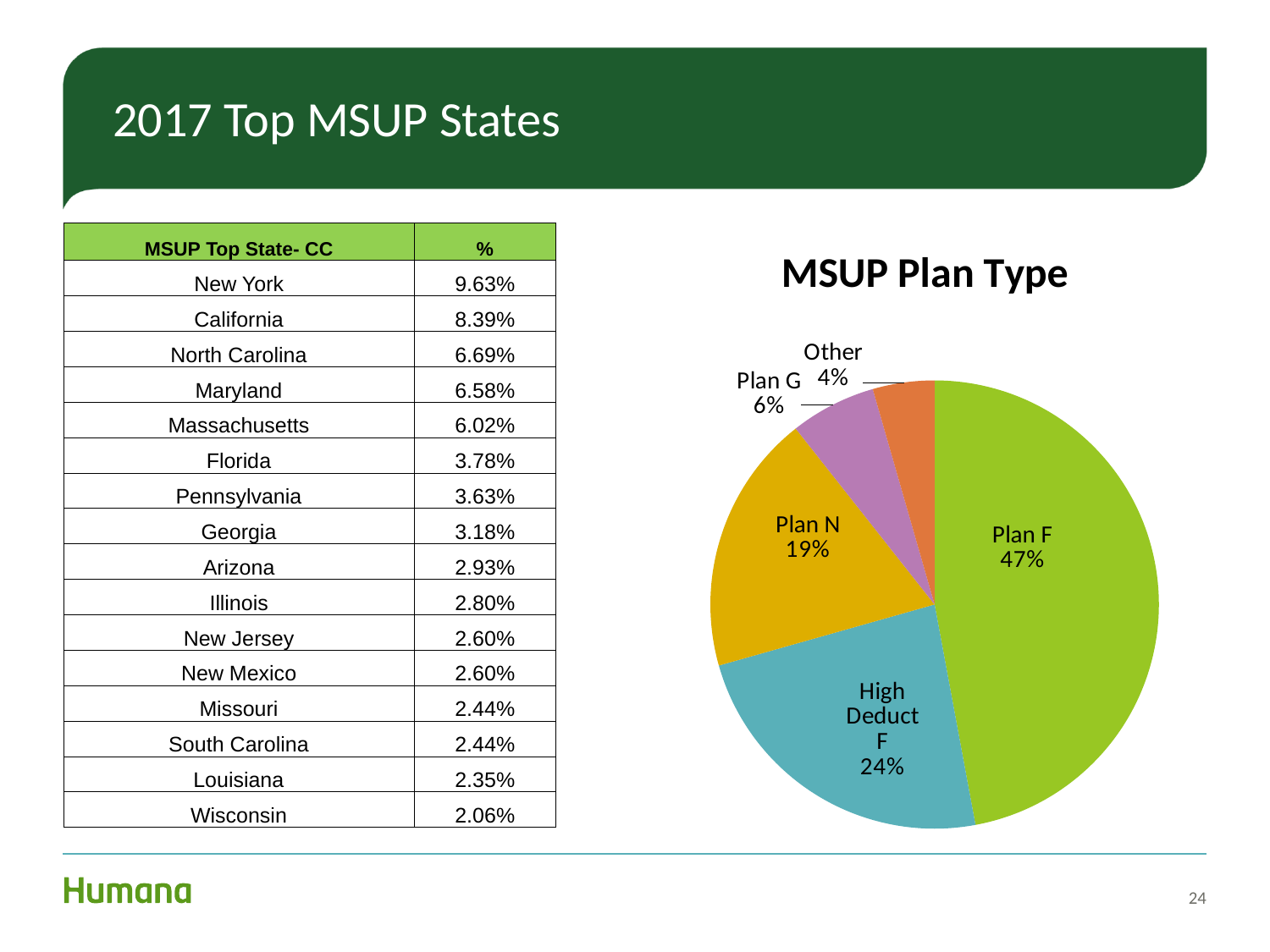
In the MSUP Plan Type chart, what share does Plan G have? 6% In the MSUP Plan Type chart, what share does High Deduct F have? 24% How many slices does the MSUP Plan Type pie chart have? 5 In the MSUP Plan Type chart, what share does Other have? 4% In the MSUP Plan Type chart, what share does Plan N have? 19% In the MSUP Plan Type chart, what share does Plan F have? 47% In the MSUP Plan Type chart, which is larger, Plan N or Plan G? Plan N Which plan type has the largest slice in the MSUP Plan Type chart? Plan F What is the title of the pie chart on the slide? MSUP Plan Type What type of chart is the MSUP Plan Type chart? pie chart In the MSUP Plan Type chart, what is the difference in percentage points between Plan F and High Deduct F? 23 Which plan type has the smallest slice in the MSUP Plan Type chart? Other